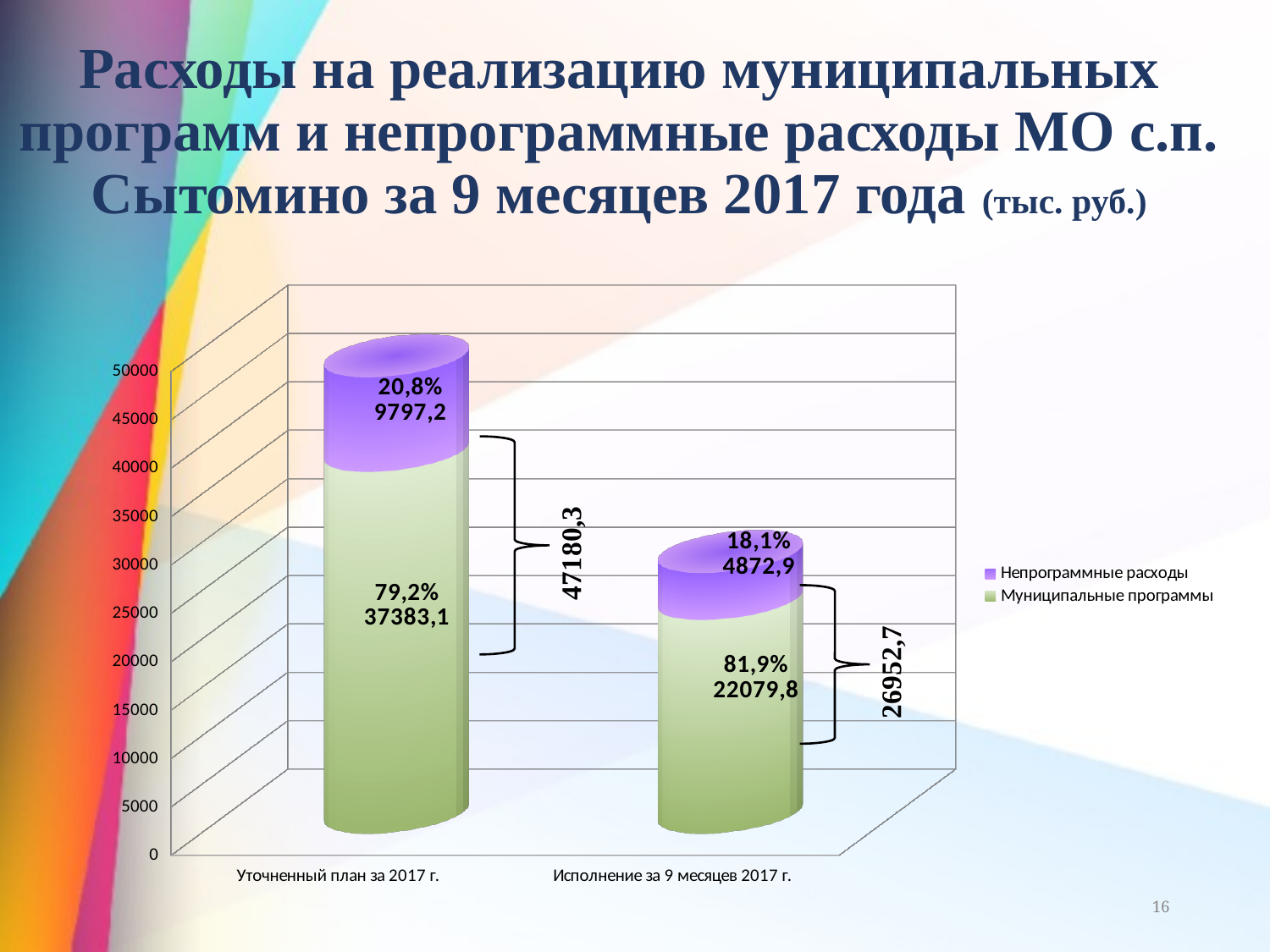
How many categories are shown on the x axis? 2 What is the value of Муниципальные программы for Уточненный план за 2017 г.? 37383,1 What is the value of Непрограммные расходы for Исполнение за 9 месяцев 2017 г.? 4872,9 What percentage share is shown for Муниципальные программы in Исполнение за 9 месяцев 2017 г.? 81,9% What is the total of the stacked bar for Исполнение за 9 месяцев 2017 г.? 26952,7 Which category has the higher value for Непрограммные расходы? Уточненный план за 2017 г. What percentage share is shown for Непрограммные расходы in Уточненный план за 2017 г.? 20,8% What kind of chart is shown on the slide? Stacked bar chart Which colour represents Непрограммные расходы in the legend? Purple How many series does the legend list? 2 What is the difference between Муниципальные программы in Уточненный план за 2017 г. and in Исполнение за 9 месяцев 2017 г.? 15303,3 What is the total of the stacked bar for Уточненный план за 2017 г.? 47180,3